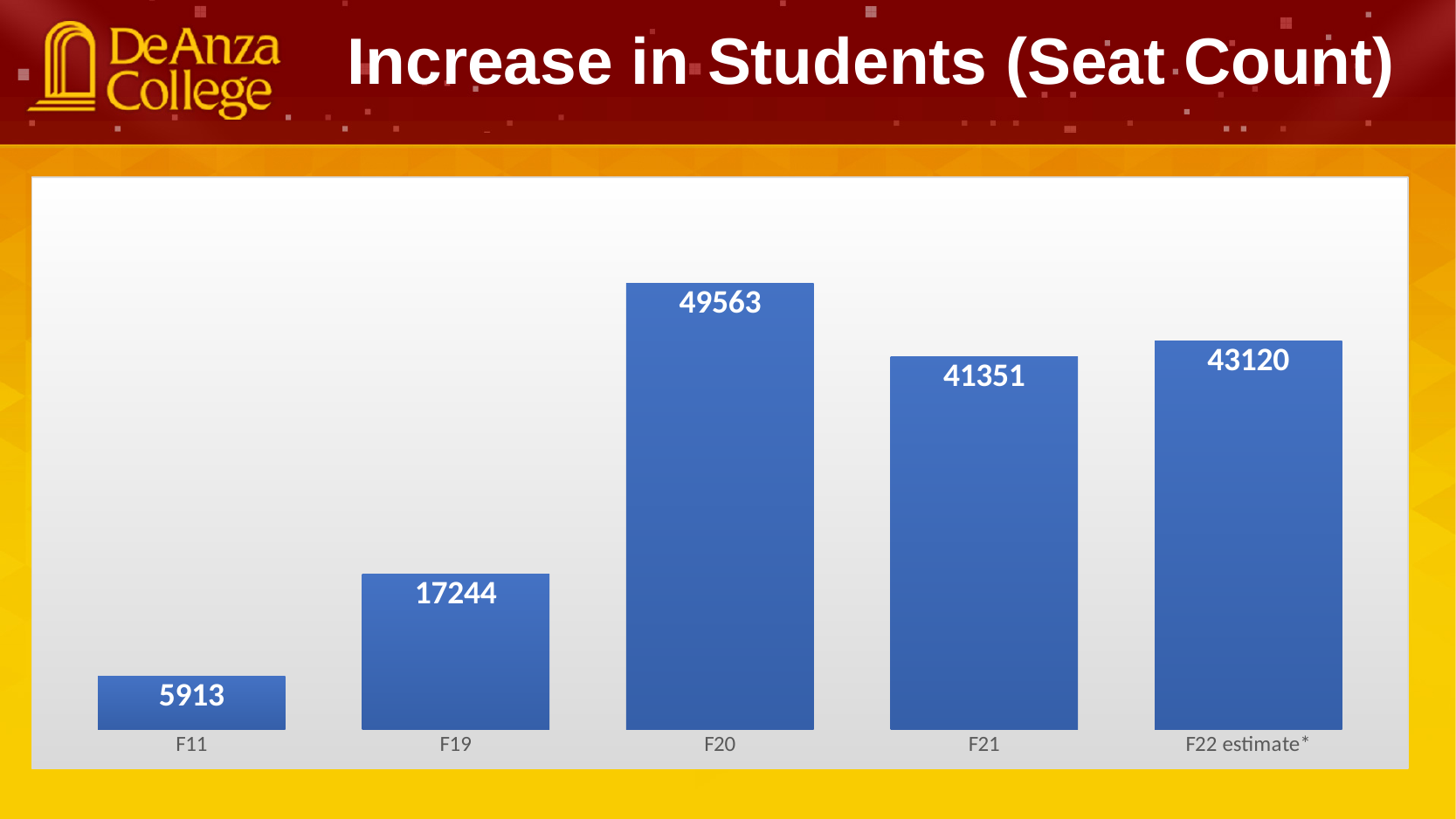
What is the difference between the seat counts for F20 and F21? 8212 What kind of chart is shown on the slide? Bar chart What is the seat count for F20? 49563 Which category has the lowest seat count? F11 Which category has the highest seat count? F20 What is the seat count for F19? 17244 What is the value shown for F22 estimate*? 43120 Which is larger, the value for F21 or the value for F22 estimate*? F22 estimate* What is the seat count for F21? 41351 How many categories are shown on the x axis? 5 What is the difference between the seat counts for F19 and F11? 11331 What is the seat count for F11? 5913